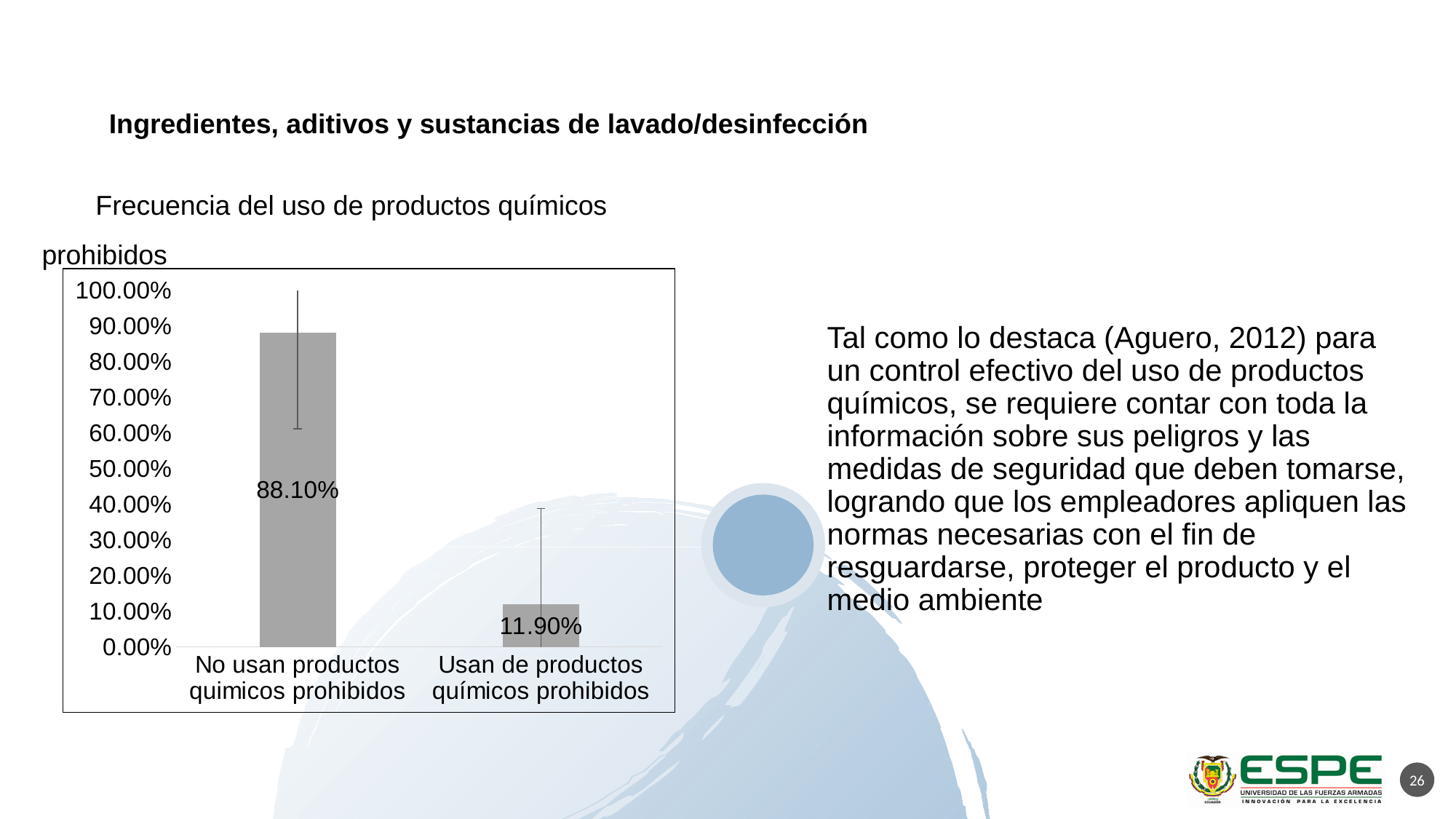
Is the value for "No usan productos quimicos prohibidos" greater or less than 80.00%? greater Which is larger: the value for "No usan productos quimicos prohibidos" or for "Usan de productos químicos prohibidos"? No usan productos quimicos prohibidos What is the value for "Usan de productos químicos prohibidos"? 11.90% What kind of chart is shown on the slide? Bar chart Is the value for "Usan de productos químicos prohibidos" greater or less than 20.00%? less What is the value for "No usan productos quimicos prohibidos"? 88.10% What is the difference between the values for "No usan productos quimicos prohibidos" and "Usan de productos químicos prohibidos"? 76.20% Which category has the lowest value? Usan de productos químicos prohibidos What is the highest value shown on the chart's vertical axis? 100.00% What is the title of the chart? Frecuencia del uso de productos químicos prohibidos Which category has the highest value? No usan productos quimicos prohibidos How many categories are shown on the chart? 2